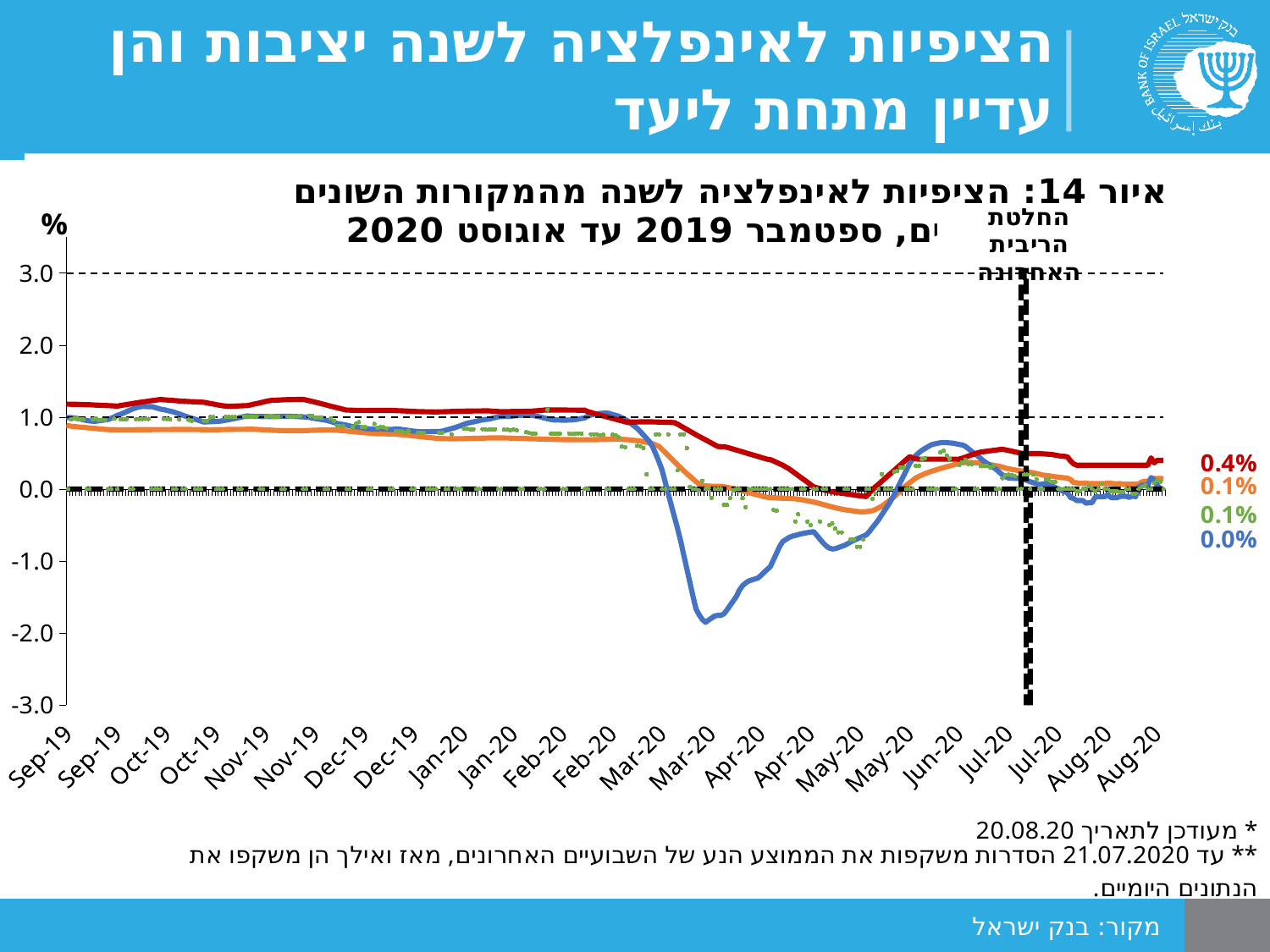
Which line reaches the lowest value over the whole period? the blue line Is the lowest point of the blue line (around Mar-20) greater or less than -1.0? less Which line has the highest labelled value at the end of the period (Aug-20)? the red line (0.4%) Is the value of the red line in Nov-19 greater or less than 1.0? greater Does the red line rise or fall between Feb-20 and Apr-20? fall What is the difference between the end-of-period labelled values of the red line and the blue line? 0.4% What is the value labelled at the end of the red line (Aug-20)? 0.4% What kind of chart is shown on the slide? line chart What is the value labelled at the end of the blue line (Aug-20)? 0.0% At the end of the period, is the red line's labelled value larger or smaller than the orange line's? larger How many lines are plotted on the chart? 4 What is the value labelled at the end of the orange line (Aug-20)? 0.1%